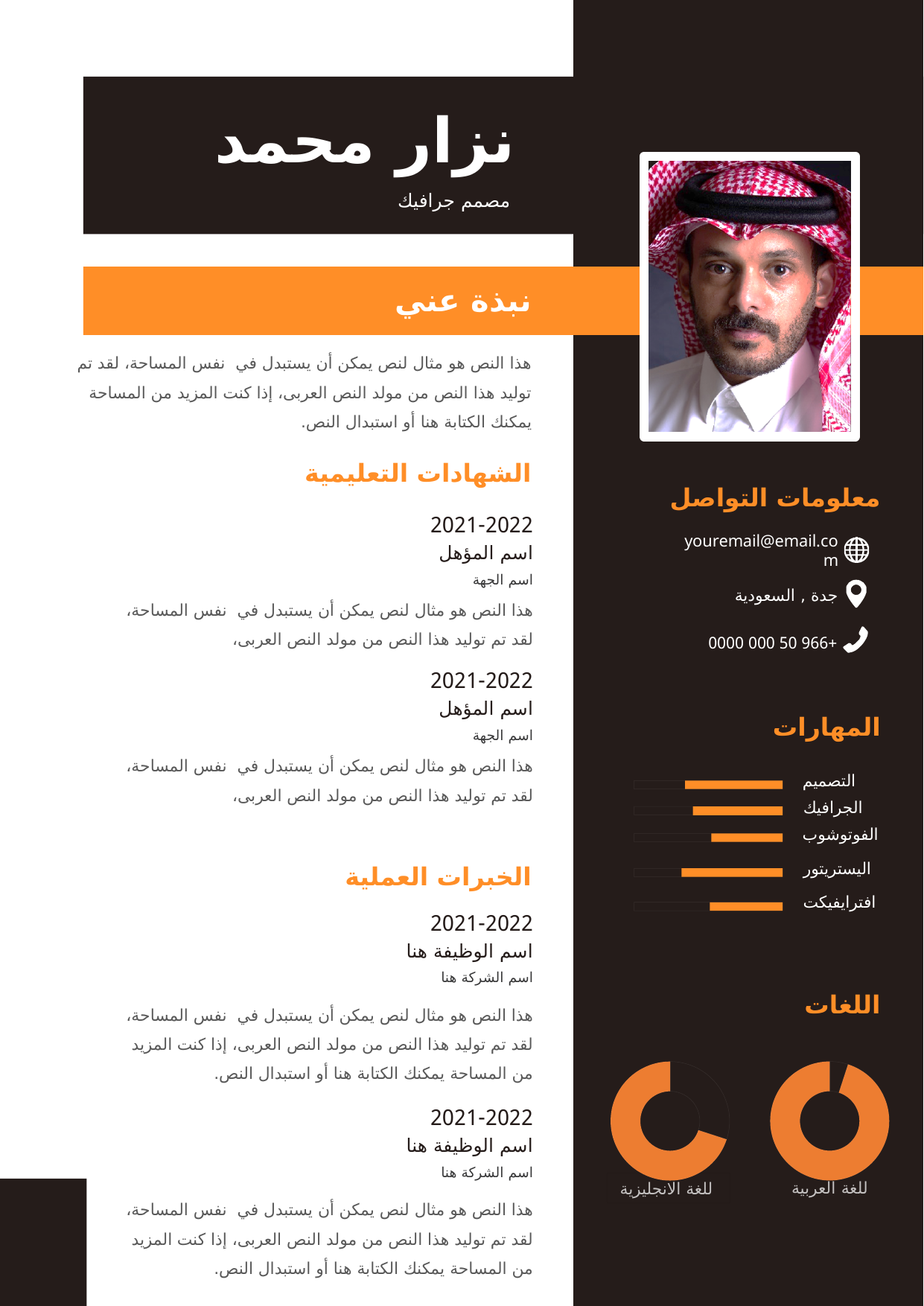
What kind of chart is used in the languages section (اللغات) of the slide? Pie (donut) chart How many skills are listed with bars in the skills section (المهارات)? 5 How many donut charts are shown in the languages section (اللغات)? 2 In the skills section (المهارات), which bar is longer: التصميم or الفوتوشوب? التصميم What are the labels of the two donut charts in the languages section? للغة العربية and للغة الانجليزية What colour are the filled portions of the skill bars and the donut charts? Orange In the skills section (المهارات), which bar is longer: اليستريتور or افترايفيكت? اليستريتور In the languages section, is the orange share of the للغة الانجليزية donut greater or less than 50%? greater In the languages section, which donut chart has the larger orange share: للغة العربية or للغة الانجليزية? للغة العربية In the languages section, is the orange share of the للغة العربية donut greater or less than 50%? greater In the languages section, which donut chart has the smaller orange share? للغة الانجليزية